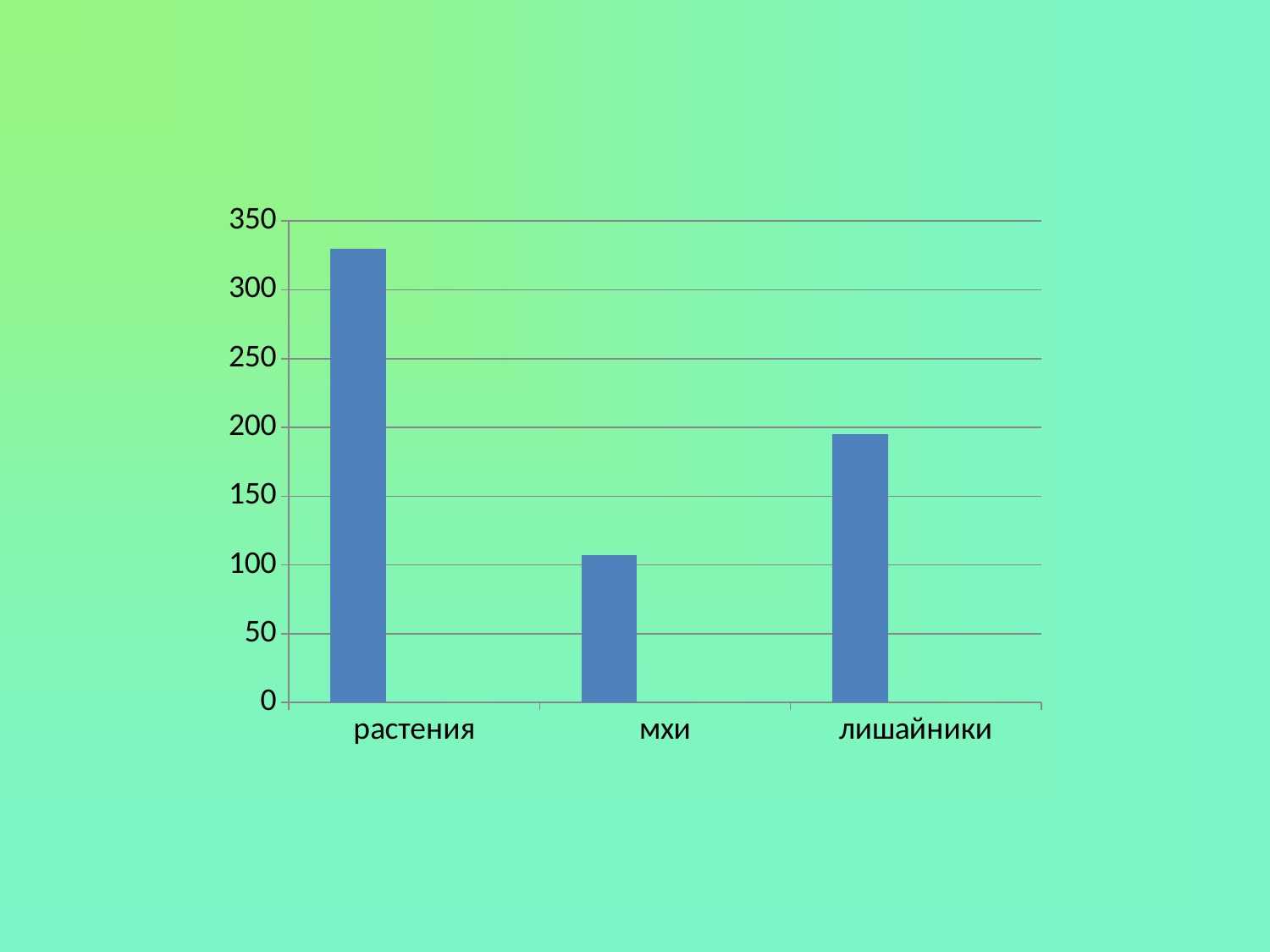
Is the value for лишайники greater or less than 250? less Which category has the highest bar in the chart? растения Which is larger, the value for мхи or the value for лишайники? лишайники Is the value for растения greater or less than 300? greater Is the value for мхи greater or less than 150? less Which is larger, the value for растения or the value for лишайники? растения Which category has the lowest bar in the chart? мхи What is the highest value shown on the vertical axis of the chart? 350 What kind of chart is shown on the slide? bar chart How many categories are shown on the x axis of the chart? 3 What colour are the bars in the chart? blue